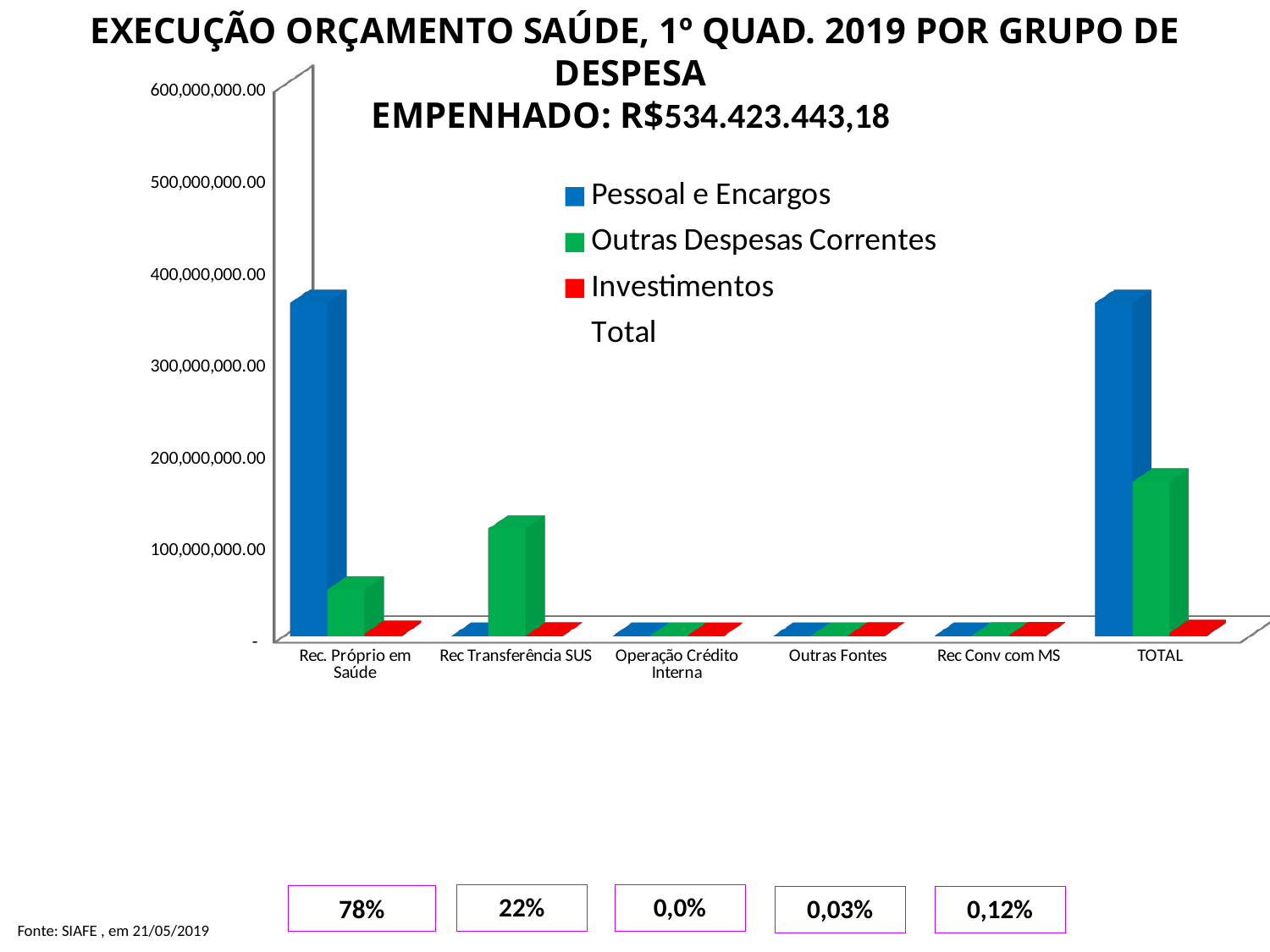
Which has the larger Outras Despesas Correntes value: Rec Transferência SUS or Rec. Próprio em Saúde? Rec Transferência SUS Which category has the highest Outras Despesas Correntes value? TOTAL Is the Outras Despesas Correntes value for Rec. Próprio em Saúde greater or less than 100,000,000.00? less For Rec. Próprio em Saúde, which is larger: Pessoal e Encargos or Outras Despesas Correntes? Pessoal e Encargos Is the Outras Despesas Correntes value for TOTAL greater or less than 200,000,000.00? less Which colour represents Investimentos in the chart legend? red Is the Pessoal e Encargos value for Rec. Próprio em Saúde greater or less than 300,000,000.00? greater What total empenhado amount is stated in the chart title? R$534.423.443,18 How many series does the chart legend list? 4 How many categories are shown on the x axis of the chart? 6 What kind of chart is shown on the slide? bar chart